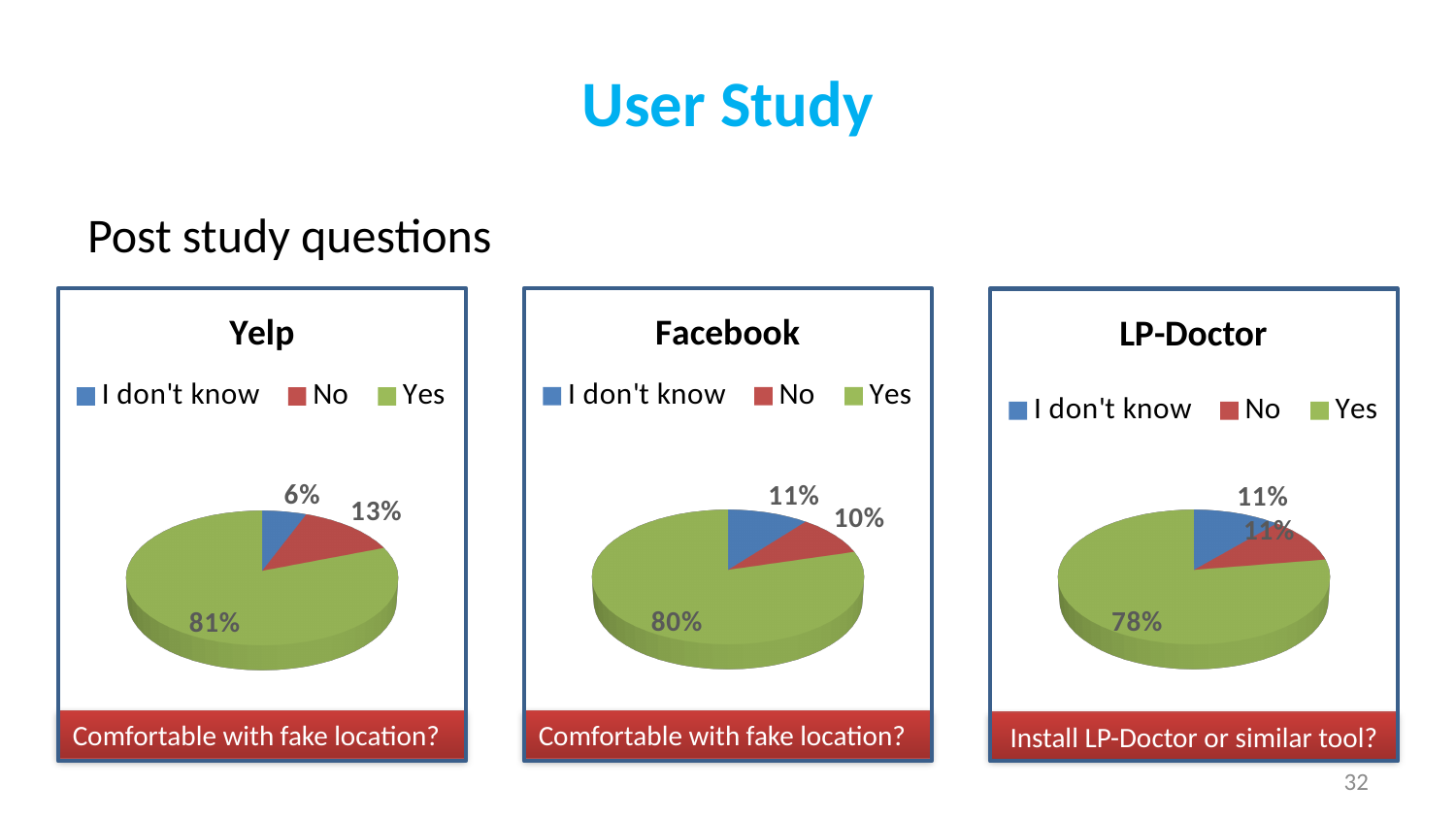
In the Yelp chart, which is larger, the No share or the I don't know share? No In the Yelp chart, what percentage of respondents answered Yes? 81% In the Facebook chart, which response has the largest share? Yes What question is shown beneath the LP-Doctor chart? Install LP-Doctor or similar tool? In the Yelp chart, what is the difference between the Yes share and the No share? 68% What kind of chart is used for the Facebook data? Pie chart In the Facebook chart, what percentage answered I don't know? 11% How many entries does the legend of the Yelp chart list? 3 How many slices does the LP-Doctor pie chart have? 3 In the LP-Doctor chart, what percentage answered Yes? 78% In the Yelp chart, what percentage answered No? 13% In the Yelp chart, which response has the smallest share? I don't know